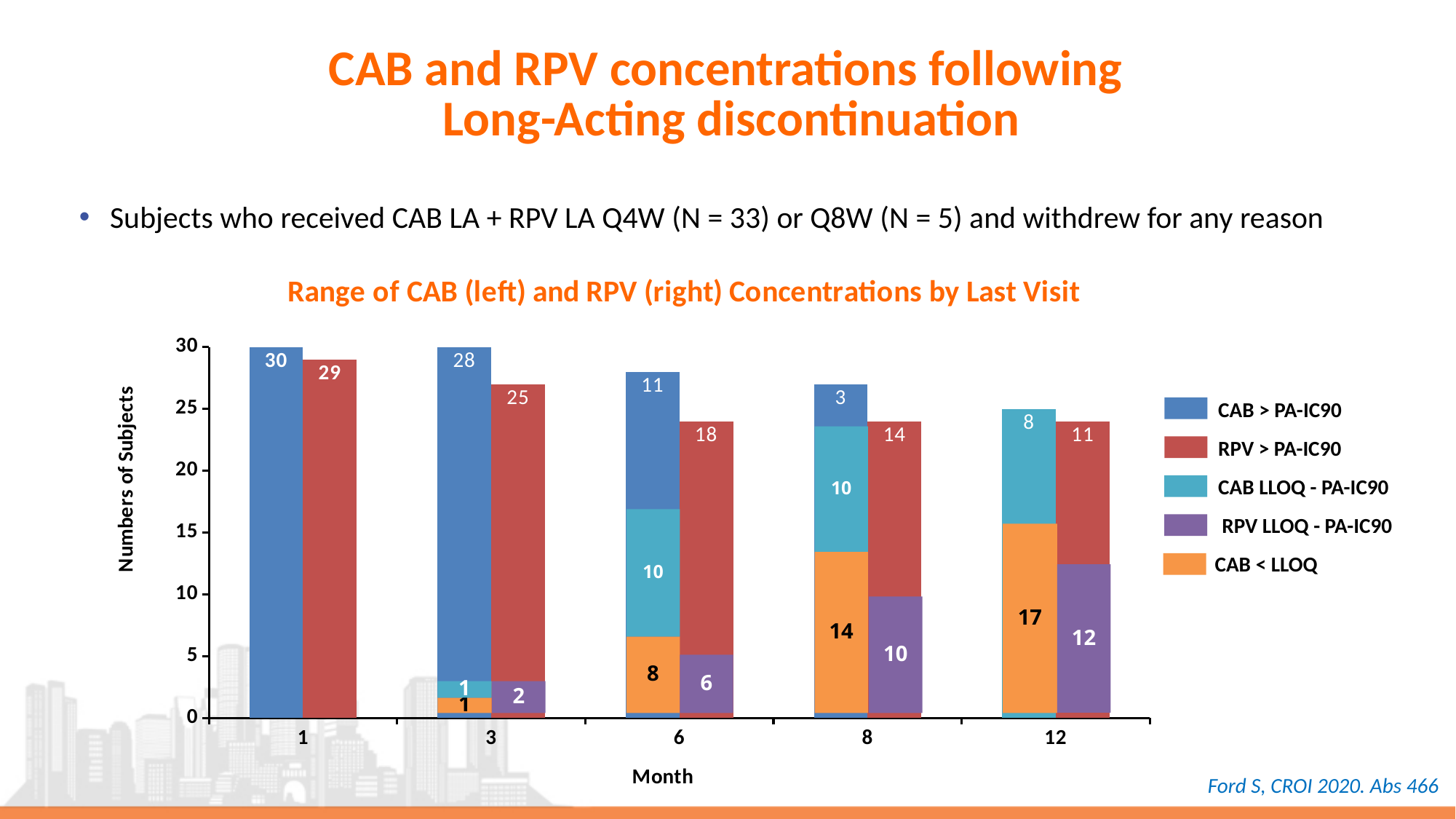
What type of chart is shown on the slide? stacked bar chart What is the difference between the CAB > PA-IC90 value at month 3 and at month 6? 17 What is the value for RPV > PA-IC90 at month 6? 18 What is the value for CAB < LLOQ at month 12? 17 Which is larger at month 8: CAB < LLOQ or RPV > PA-IC90? Neither; both are 14 What is the value for RPV LLOQ - PA-IC90 at month 8? 10 How many months are shown on the x axis? 5 Does the RPV > PA-IC90 value rise or fall from month 1 to month 12? fall What is the total of the stacked CAB bar at month 6 (CAB > PA-IC90, CAB LLOQ - PA-IC90 and CAB < LLOQ)? 29 What is the value for CAB > PA-IC90 at month 1? 30 How many series does the legend list? 5 At which month is the CAB > PA-IC90 value highest? 1